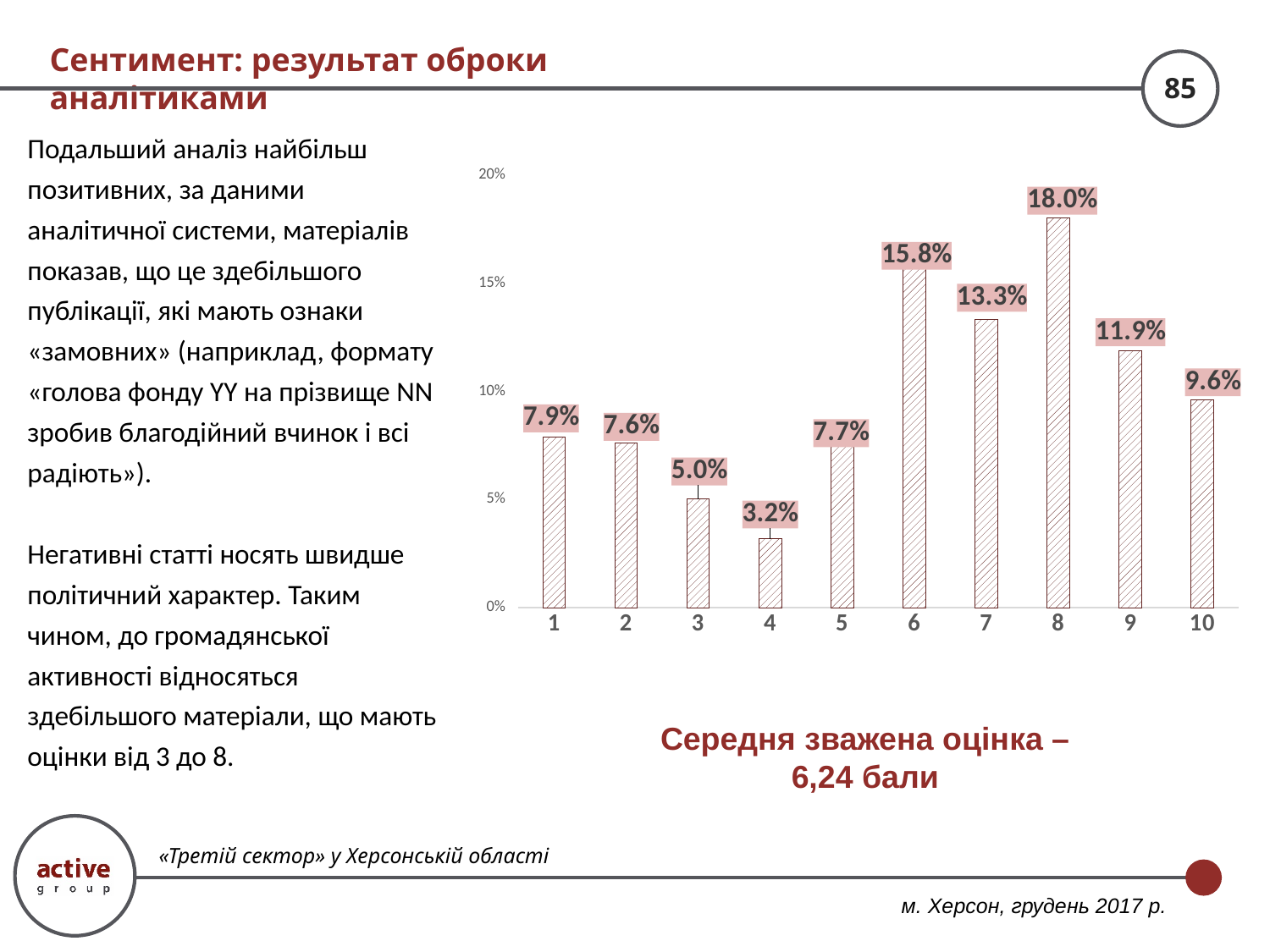
What is the value for category 8? 18.0% Which is larger, the value for category 1 or the value for category 2? 1 What is the value for category 4? 3.2% Which category has the lowest value? 4 Which category has the highest value? 8 What is the difference between the values for category 8 and category 7? 4.7% Do the values rise or fall from category 3 to category 4? fall What kind of chart is shown on the slide? bar chart Is the value for category 9 greater or less than 10%? greater What is the value for category 6? 15.8% How many categories are shown on the x axis? 10 What is the average weighted score stated below the chart? 6,24 бали